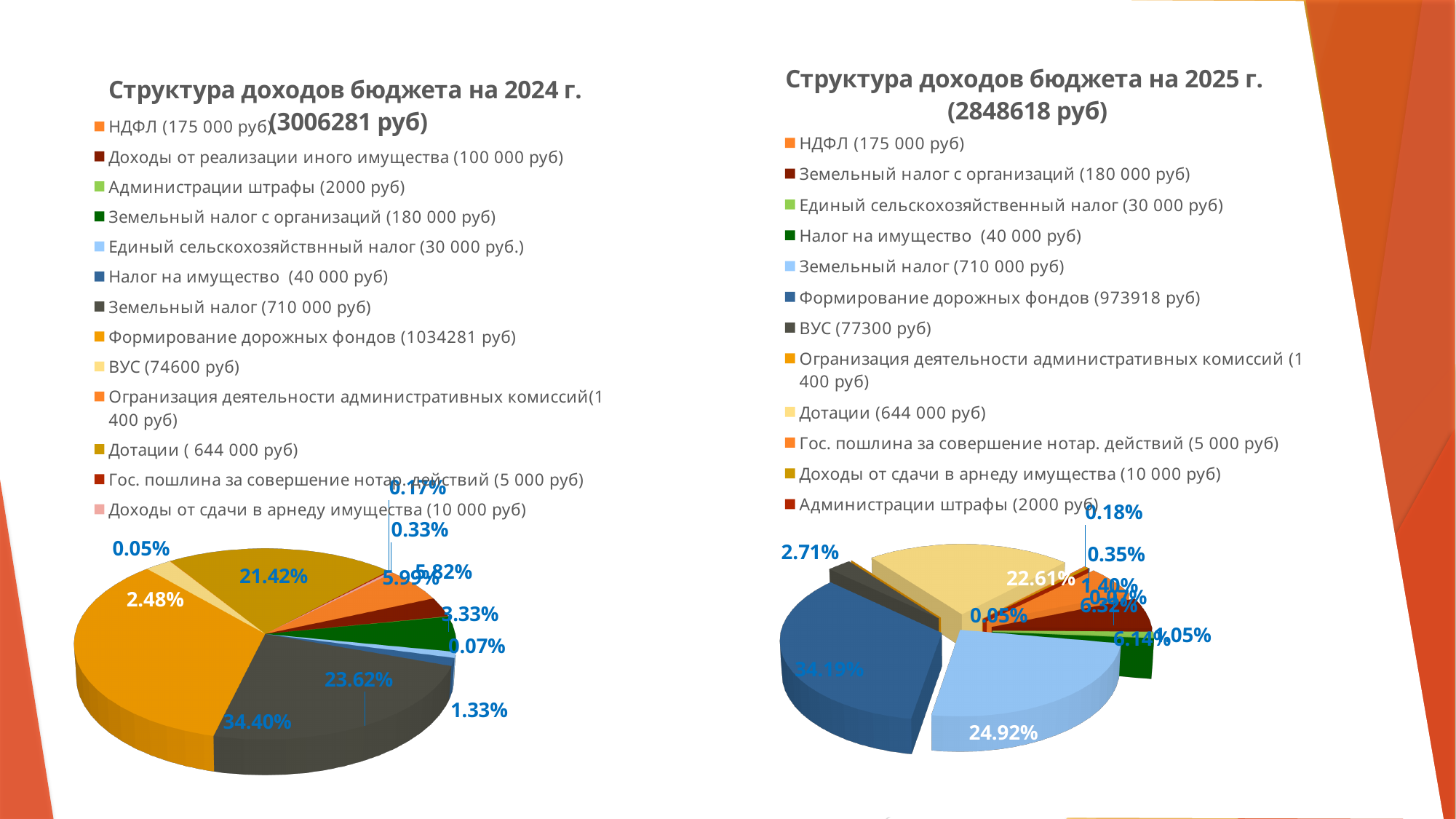
What kind of chart is used on the left for 'Структура доходов бюджета на 2024 г.'? pie chart In the 2024 chart, which category has the largest share of the pie? Формирование дорожных фондов (1034281 руб) In the 2024 chart, what total budget income is given in the title? 3006281 руб How many categories does the legend of the 2024 chart list? 13 In the 2024 chart, what share of the pie does the largest slice (Формирование дорожных фондов) have? 34.40% How many categories does the legend of the 2025 chart list? 12 In the 2025 chart, what share of the pie does Земельный налог (710 000 руб) have? 24.92% In the 2025 chart, what total budget income is given in the title? 2848618 руб In the 2025 chart, what amount is given in the legend for Формирование дорожных фондов? 973918 руб In the 2025 chart, what share of the pie does the largest slice (Формирование дорожных фондов) have? 34.19% In the 2025 chart, which is larger according to the legend: Земельный налог (710 000 руб) or Дотации (644 000 руб)? Земельный налог (710 000 руб) In the 2024 chart, what amount is given in the legend for ВУС? 74600 руб